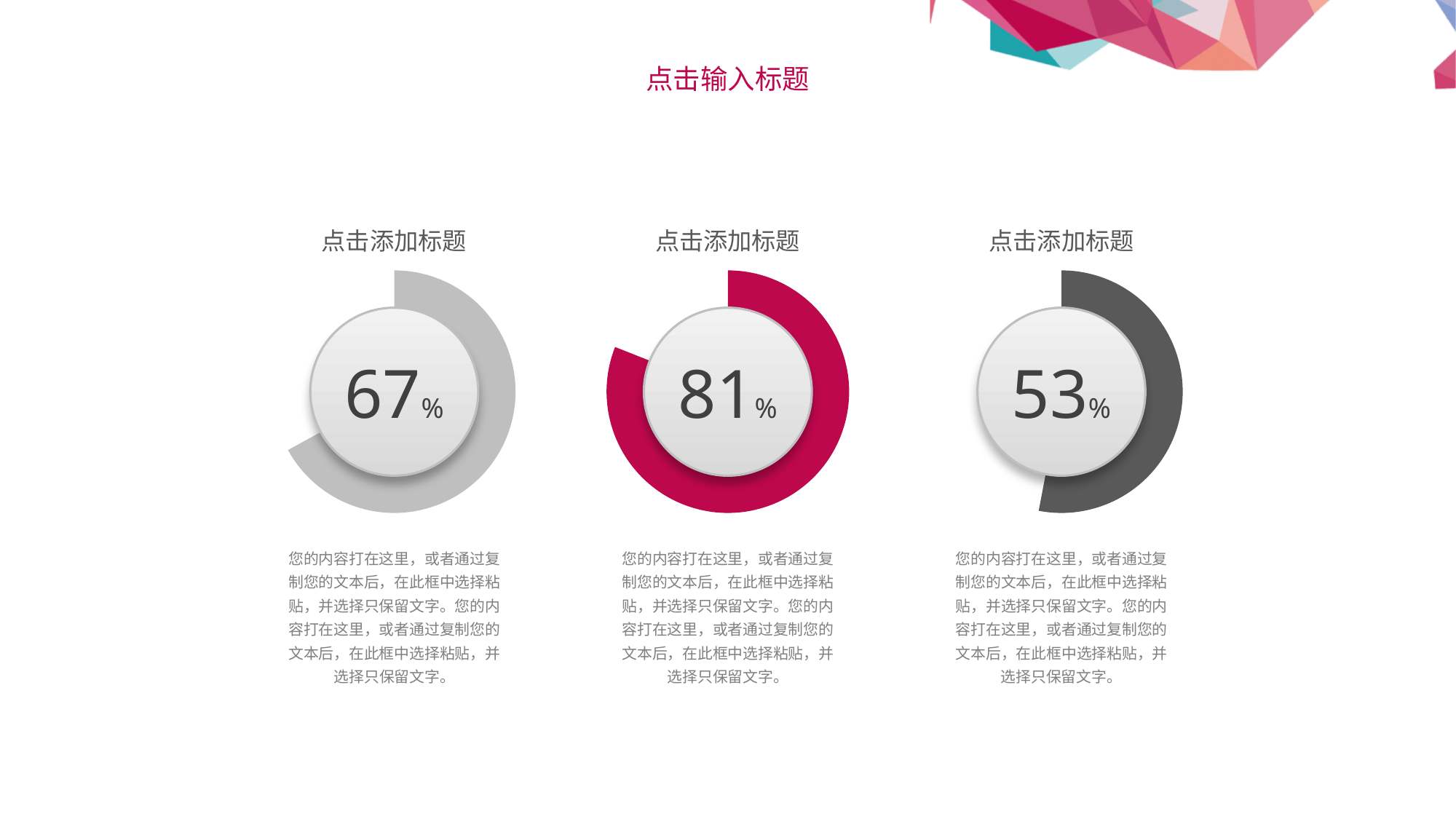
What colour is the ring of the middle chart? red (magenta) What value is shown in the right ring chart? 53% What is the difference between the value in the left ring chart and the value in the right ring chart? 14% What value is shown in the middle ring chart? 81% Which of the three ring charts shows the highest value? the middle chart (81%) Which is larger, the value in the left ring chart or the value in the right ring chart? the left chart (67%) What value is shown in the left ring chart? 67% What is the difference between the value in the middle ring chart and the value in the left ring chart? 14% Which of the three ring charts shows the lowest value? the right chart (53%) What colour is the ring of the right chart? dark grey How many ring charts are shown on the slide? 3 What kind of chart is used to display the three percentages on the slide? ring (donut) chart